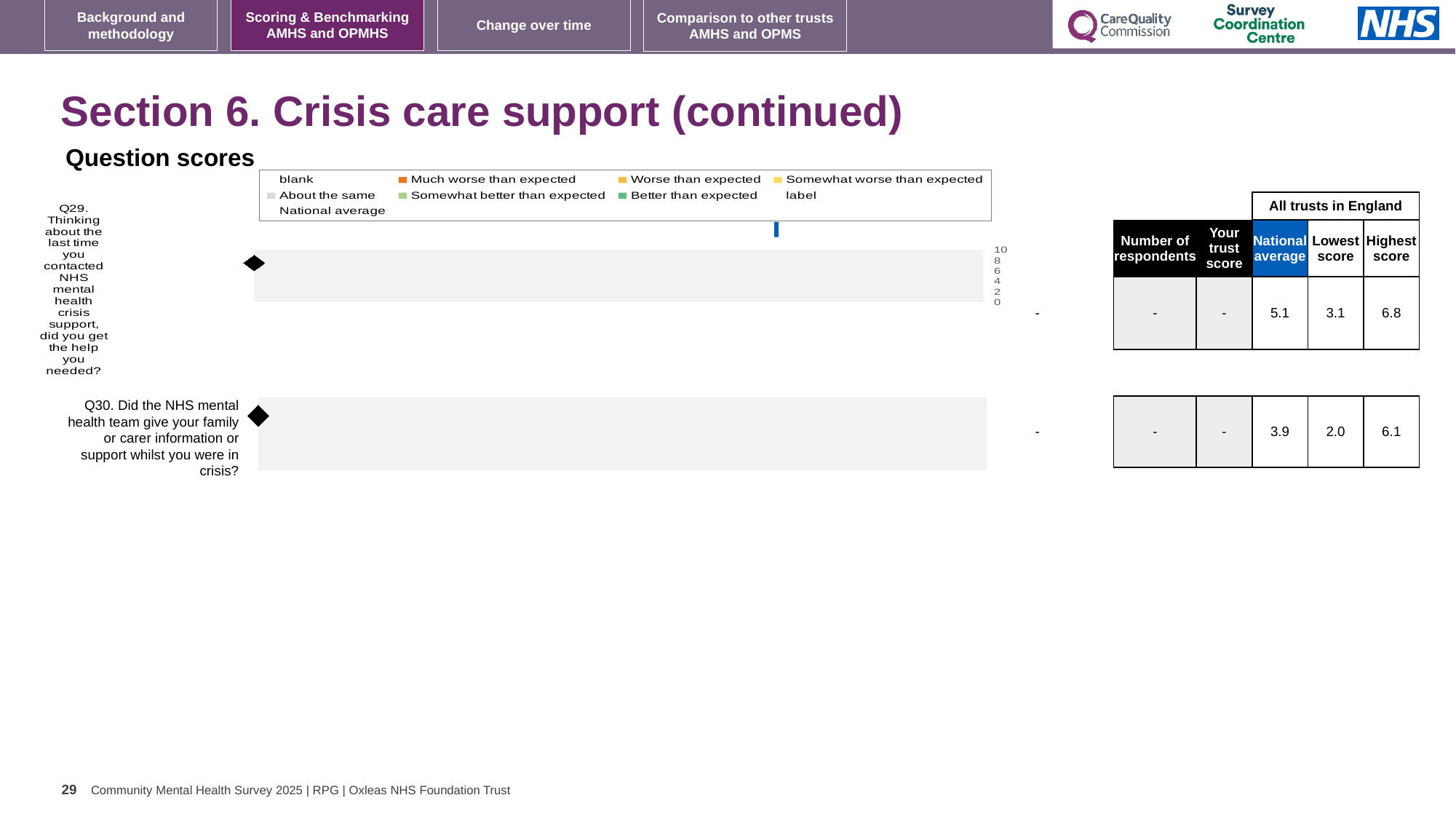
In the table next to the chart, what is the national average for Q30? 3.9 In the table next to the chart, what is the national average for Q29? 5.1 What is shown as the trust score for Q29 in the table? - What colour does the legend use for 'Much worse than expected'? orange In the table next to the chart, what is the highest score for Q29? 6.8 What is the difference between the highest score and the lowest score for Q30 in the table? 4.1 Which question has the higher national average in the table, Q29 or Q30? Q29 What kind of chart is shown under 'Question scores'? bar chart In the table next to the chart, what is the lowest score for Q30? 2.0 What is the highest value shown on the chart's axis? 10 How many questions (categories) are plotted on the chart? 2 What is the difference between the highest score and the lowest score for Q29 in the table? 3.7